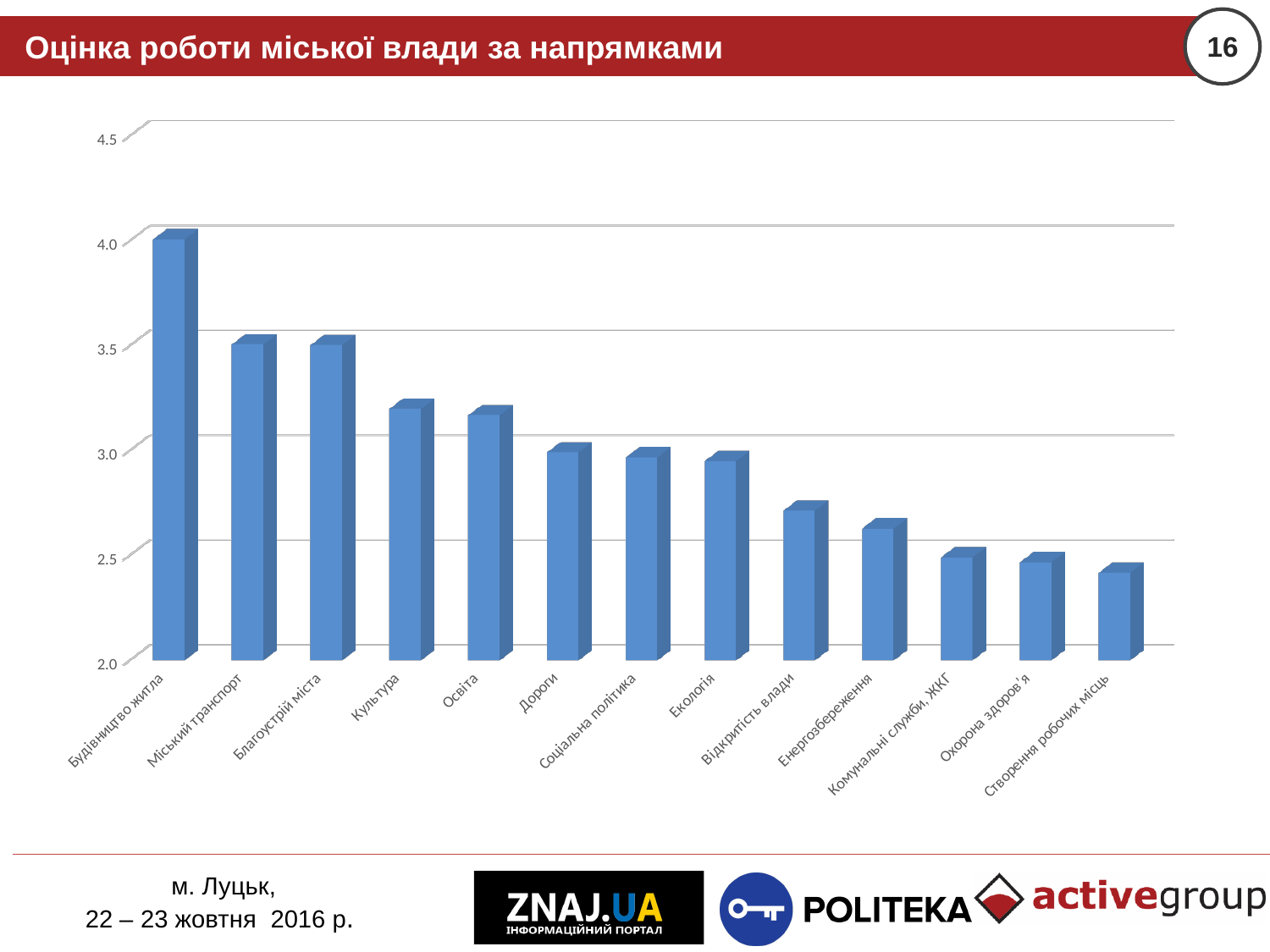
Which category has the lowest rating on the chart? Створення робочих місць Is the value for Культура greater or less than 3.0? greater Is the value for Відкритість влади greater or less than 3.0? less Do the values rise or fall moving from left to right along the x axis? fall What is the title of the slide containing the chart? Оцінка роботи міської влади за напрямками Is the value for Створення робочих місць greater or less than 2.5? less Which has a higher rating: Освіта or Охорона здоров'я? Освіта What kind of chart is shown on the slide? bar chart How many categories (directions) are shown on the chart? 13 Which category has the highest rating on the chart? Будівництво житла